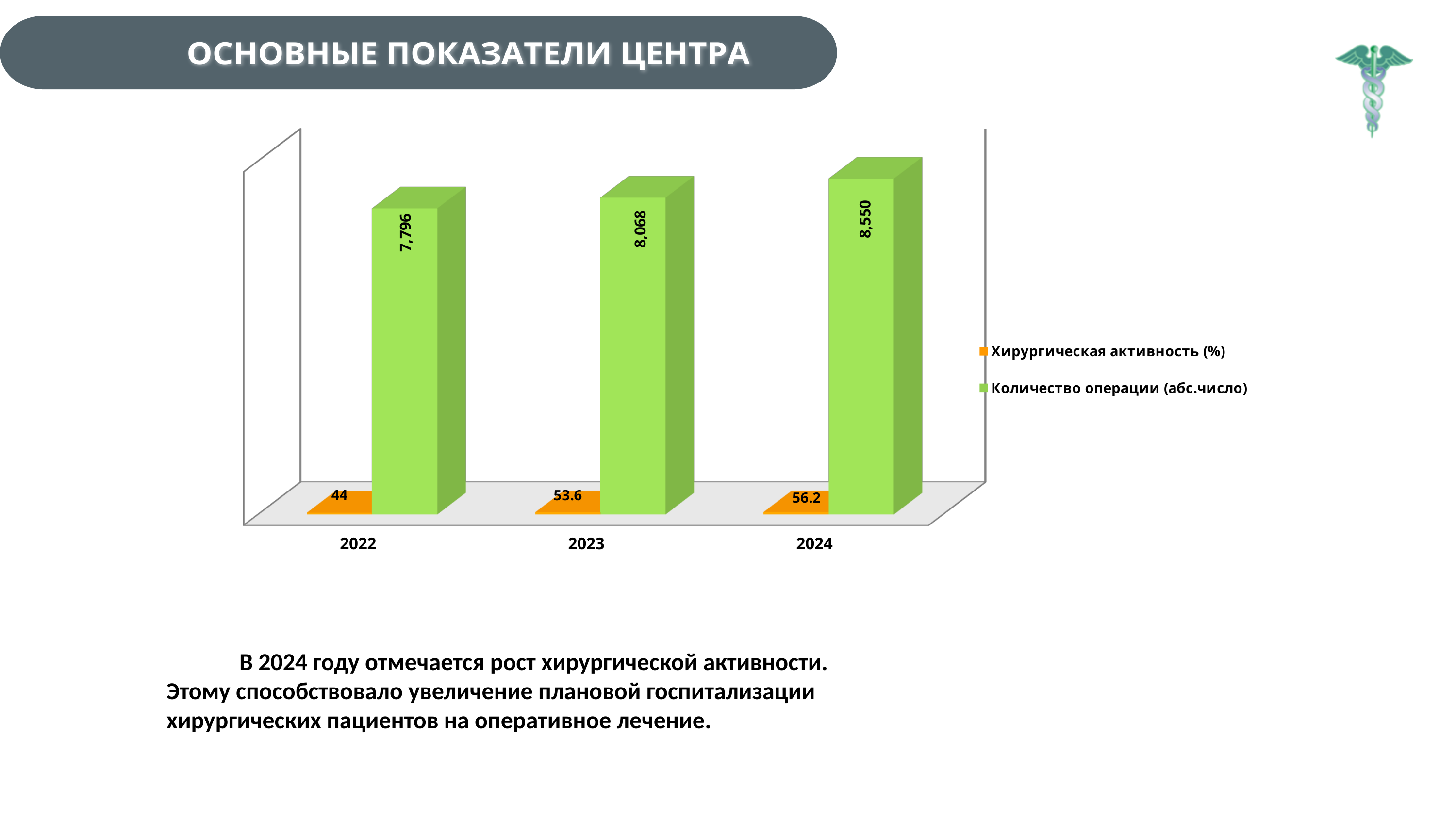
Which year has the lowest value for Хирургическая активность (%)? 2022 How many years are shown on the x axis? 3 Which year has the highest value for Количество операции (абс.число)? 2024 Which is larger: Количество операции (абс.число) for 2022 or for 2023? 2023 What is the value of Хирургическая активность (%) for 2023? 53.6 What is the difference between the Количество операции (абс.число) values for 2024 and 2023? 482 What is the difference between the Хирургическая активность (%) values for 2024 and 2022? 12.2 What is the value of Хирургическая активность (%) for 2022? 44 What is the value of Количество операции (абс.число) for 2022? 7,796 What is the value of Количество операции (абс.число) for 2024? 8,550 How many series does the legend list? 2 Does the value of Количество операции (абс.число) rise or fall from 2022 to 2024? rise